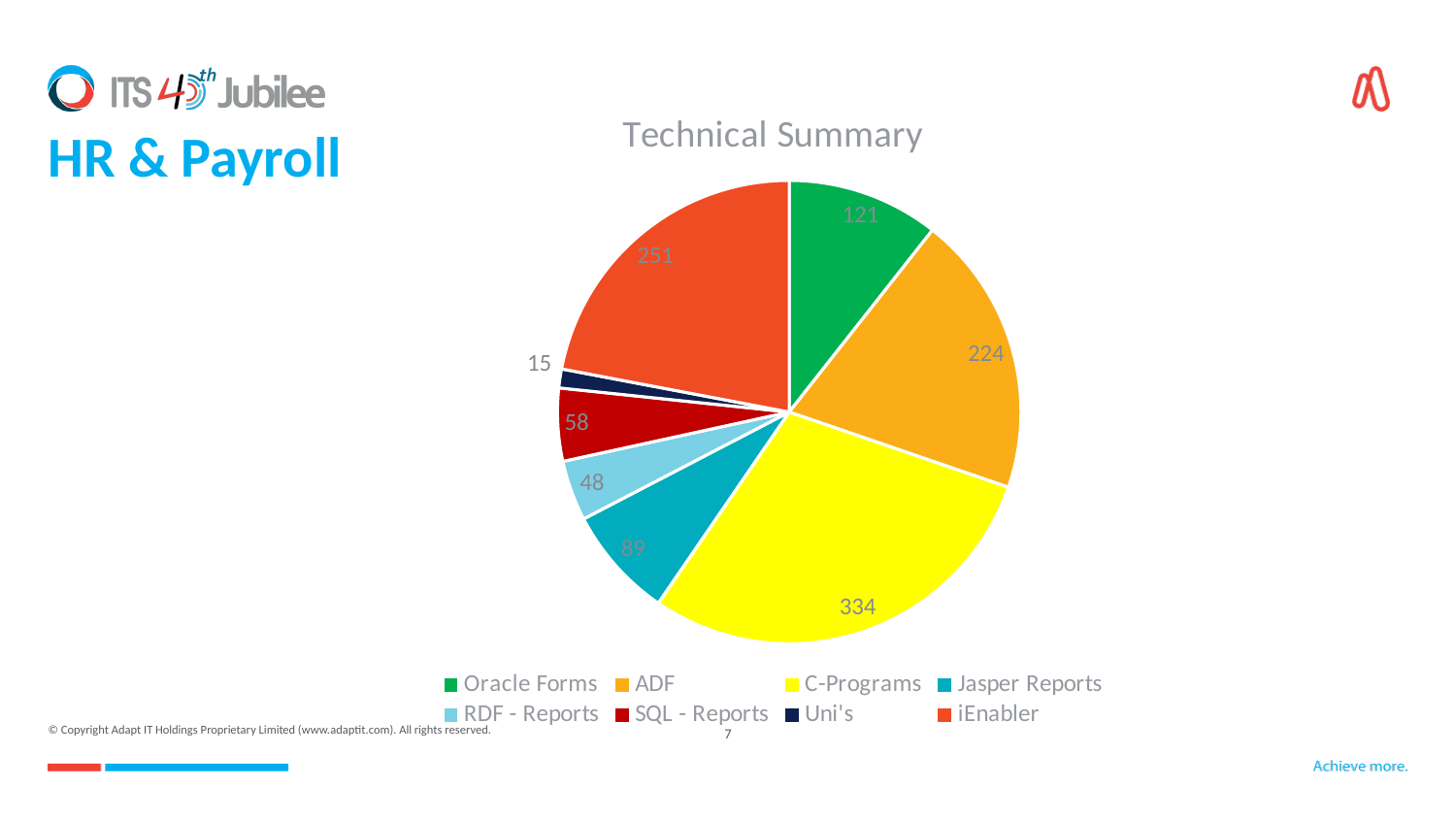
What is the title of the chart? Technical Summary How many categories does the pie chart have? 8 What is the value for Jasper Reports? 89 Which is larger, SQL - Reports or RDF - Reports? SQL - Reports What is the value for iEnabler? 251 What is the value for Uni's? 15 What is the difference between the values for ADF and Oracle Forms? 103 What is the value for C-Programs? 334 Which category has the smallest slice? Uni's What is the total of all the slices in the pie chart? 1140 Which category has the largest slice? C-Programs What type of chart is shown on the slide? Pie chart